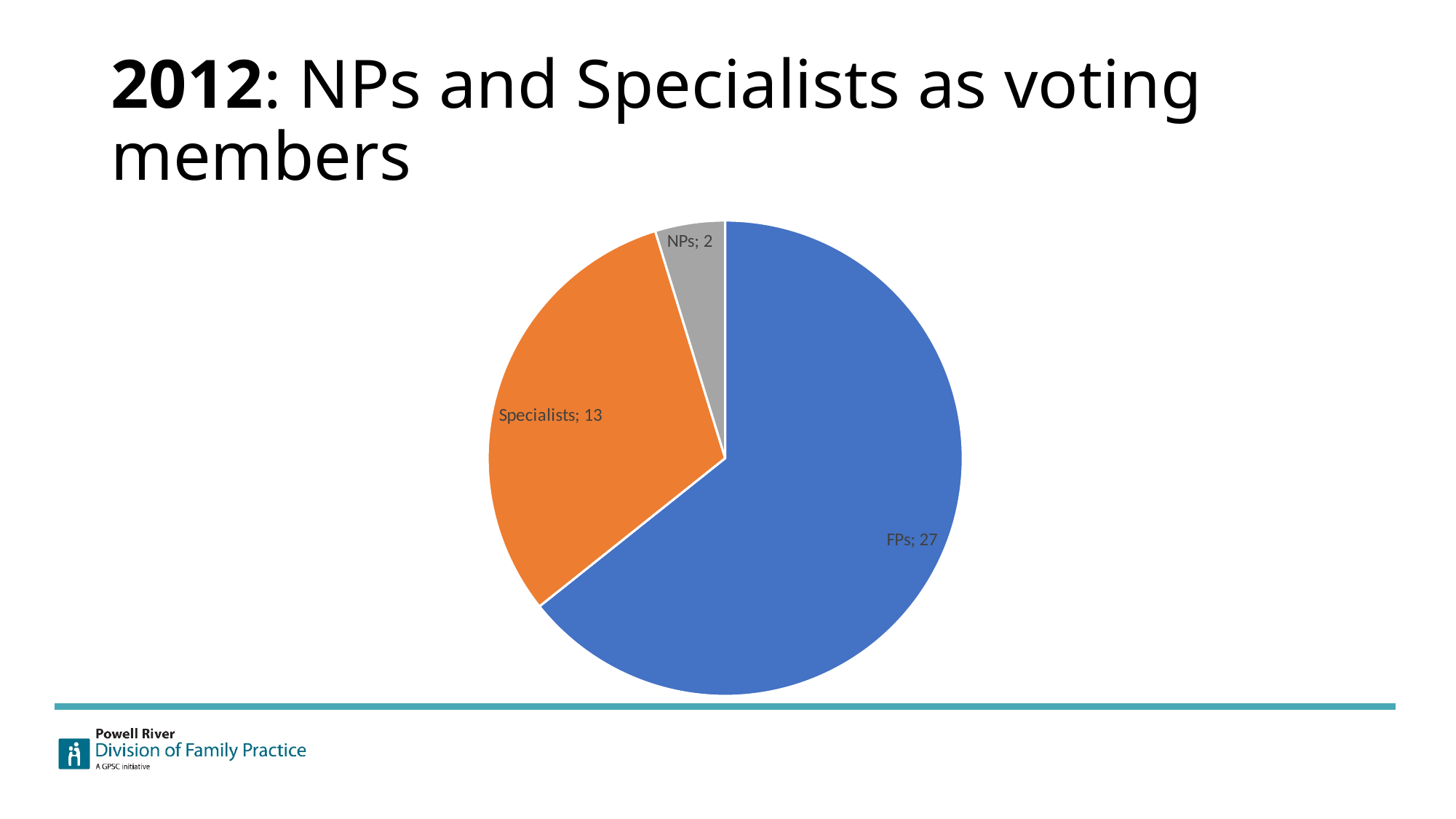
Which category has the largest slice? FPs What is the value for Specialists? 13 What is the value for FPs? 27 What is the value for NPs? 2 What colour is the FPs slice? Blue Which is larger, the value for Specialists or the value for NPs? Specialists How many categories are shown in the pie chart? 3 What kind of chart is shown on the slide? Pie chart What is the total of all slices in the pie chart? 42 What is the difference between the values for FPs and Specialists? 14 What is the difference between the values for Specialists and NPs? 11 Which category has the smallest slice? NPs